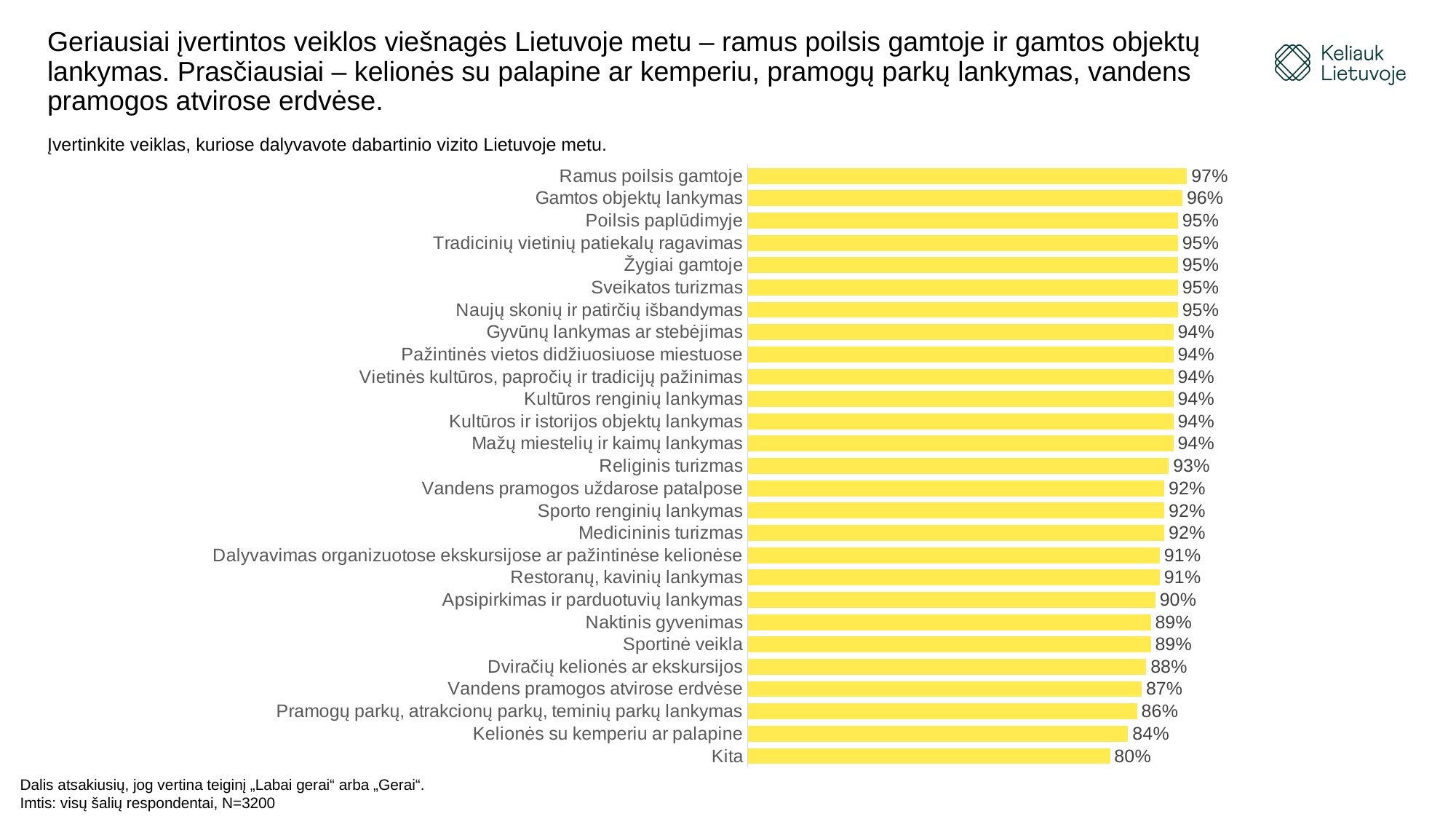
What is the difference between the values for Ramus poilsis gamtoje and Kita? 17% What is the value for Naktinis gyvenimas? 89% What is the value for Ramus poilsis gamtoje? 97% What is the difference between the values for Gamtos objektų lankymas and Vandens pramogos atvirose erdvėse? 9% How many categories are shown in the chart? 27 Which category has the lowest value? Kita What colour are the bars in the chart? Yellow Which is larger, the value for Sportinė veikla or the value for Dviračių kelionės ar ekskursijos? Sportinė veikla Which category has the highest value? Ramus poilsis gamtoje What is the value for Kelionės su kemperiu ar palapine? 84% What kind of chart is shown on the slide? Bar chart What is the value for Religinis turizmas? 93%